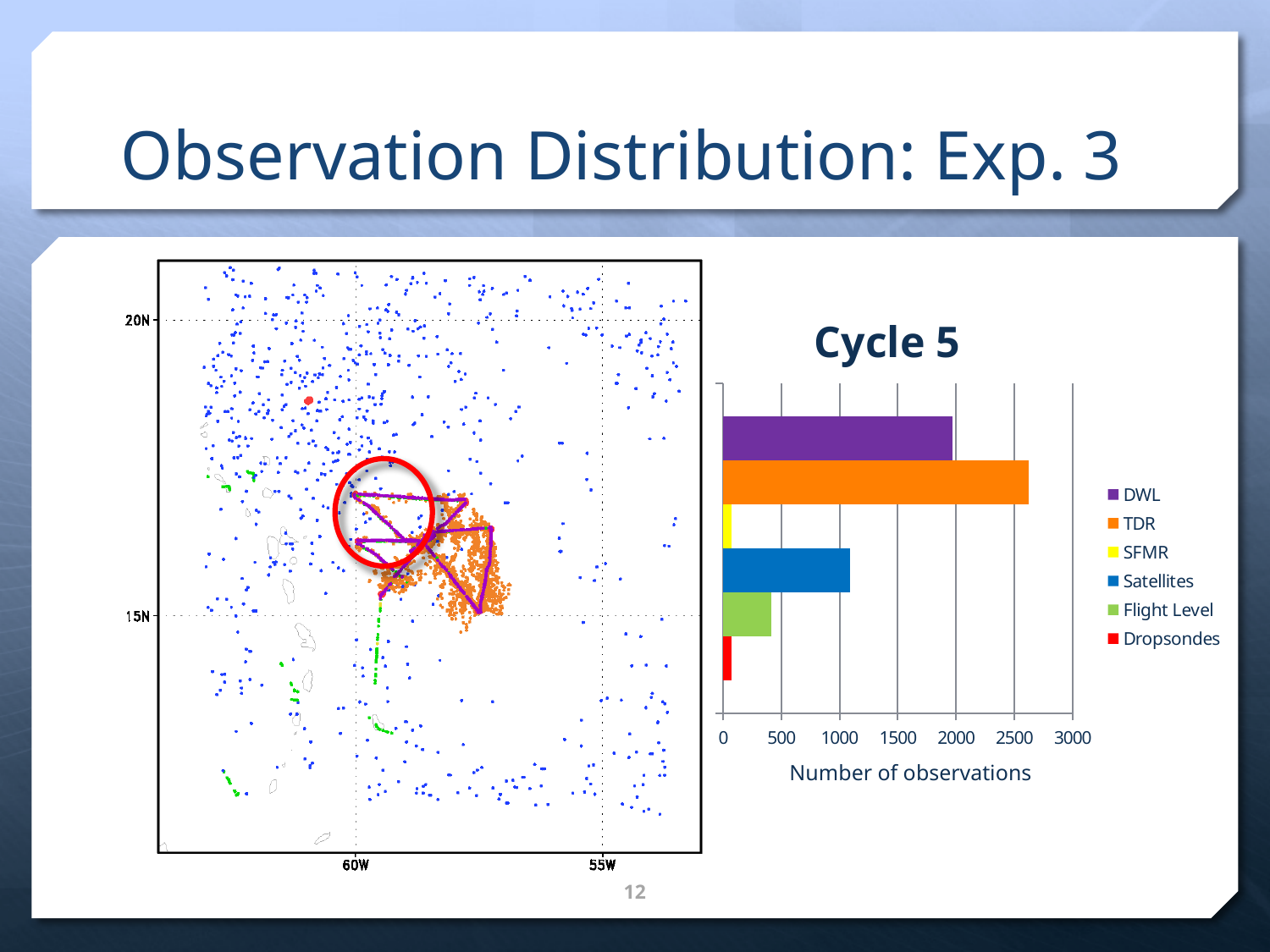
In the "Cycle 5" chart, is the value for Flight Level greater or less than 500? less In the "Cycle 5" chart, is the value for DWL greater or less than 1500? greater In the "Cycle 5" chart, is the value for TDR greater or less than 2500? greater What kind of chart is the "Cycle 5" chart on the right of the slide? bar chart In the "Cycle 5" chart, which is larger, the number of observations for TDR or for DWL? TDR How many series does the legend of the "Cycle 5" chart list? 6 In the "Cycle 5" chart, which is larger, the number of observations for Satellites or for Flight Level? Satellites In the "Cycle 5" chart, which observation type has the highest number of observations? TDR What is the title of the bar chart on the slide? Cycle 5 What is the x-axis label of the "Cycle 5" chart? Number of observations